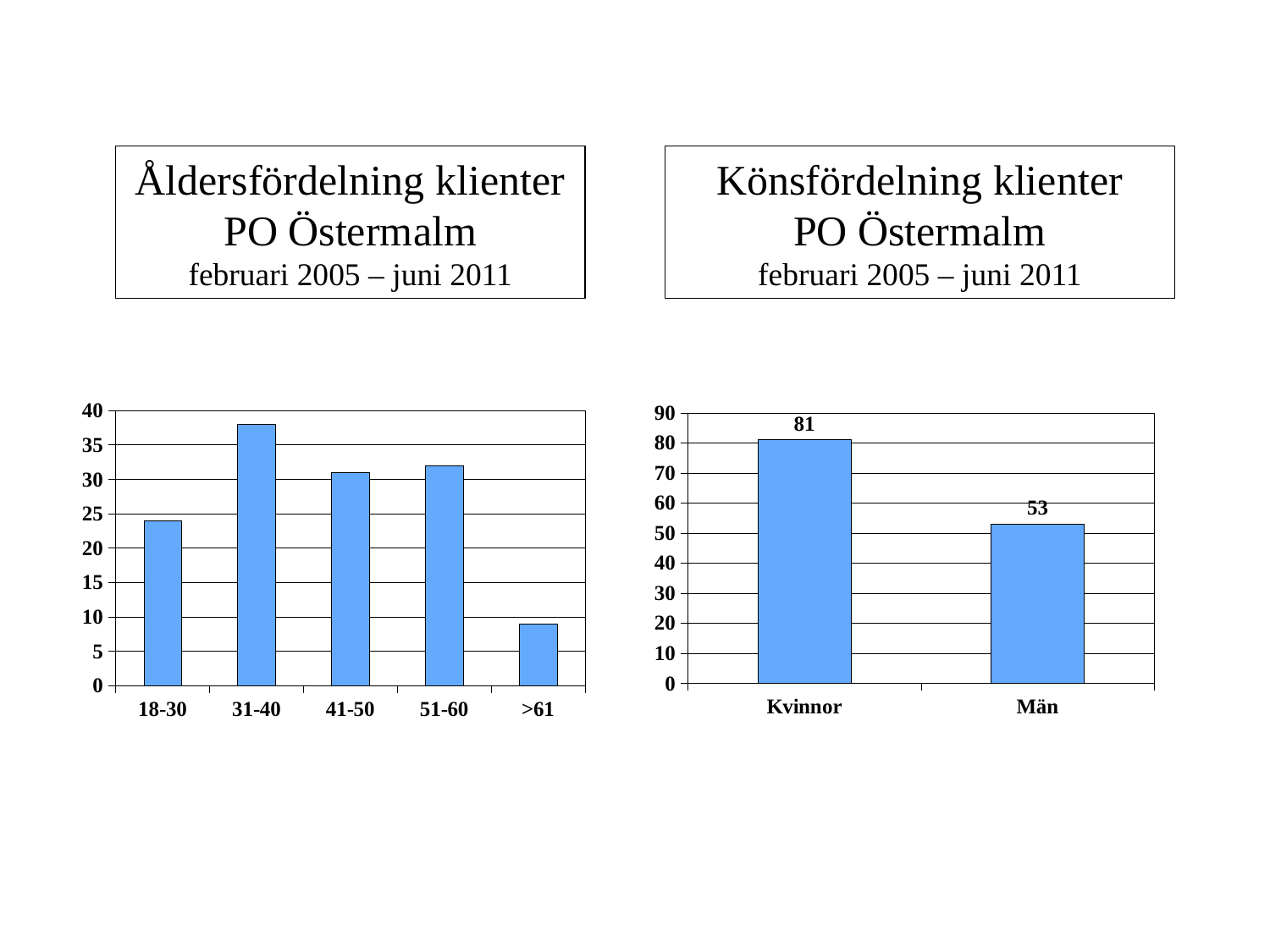
In the Åldersfördelning klienter chart, is the value for >61 greater or less than 10? less In the Åldersfördelning klienter chart, which age group has the highest bar? 31-40 In the Åldersfördelning klienter chart, which age group has the lowest bar? >61 In the Åldersfördelning klienter chart, which has the larger value, 18-30 or 41-50? 41-50 How many age groups are shown in the Åldersfördelning klienter chart? 5 In the Könsfördelning klienter chart, what is the total of the two bars? 134 What kind of chart is the Könsfördelning klienter chart? Bar chart In the Könsfördelning klienter chart, what is the value for Kvinnor? 81 In the Könsfördelning klienter chart, what is the difference between the values for Kvinnor and Män? 28 In the Könsfördelning klienter chart, which category has the higher value, Kvinnor or Män? Kvinnor In the Könsfördelning klienter chart, what is the value for Män? 53 In the Åldersfördelning klienter chart, is the value for 18-30 greater or less than 20? greater